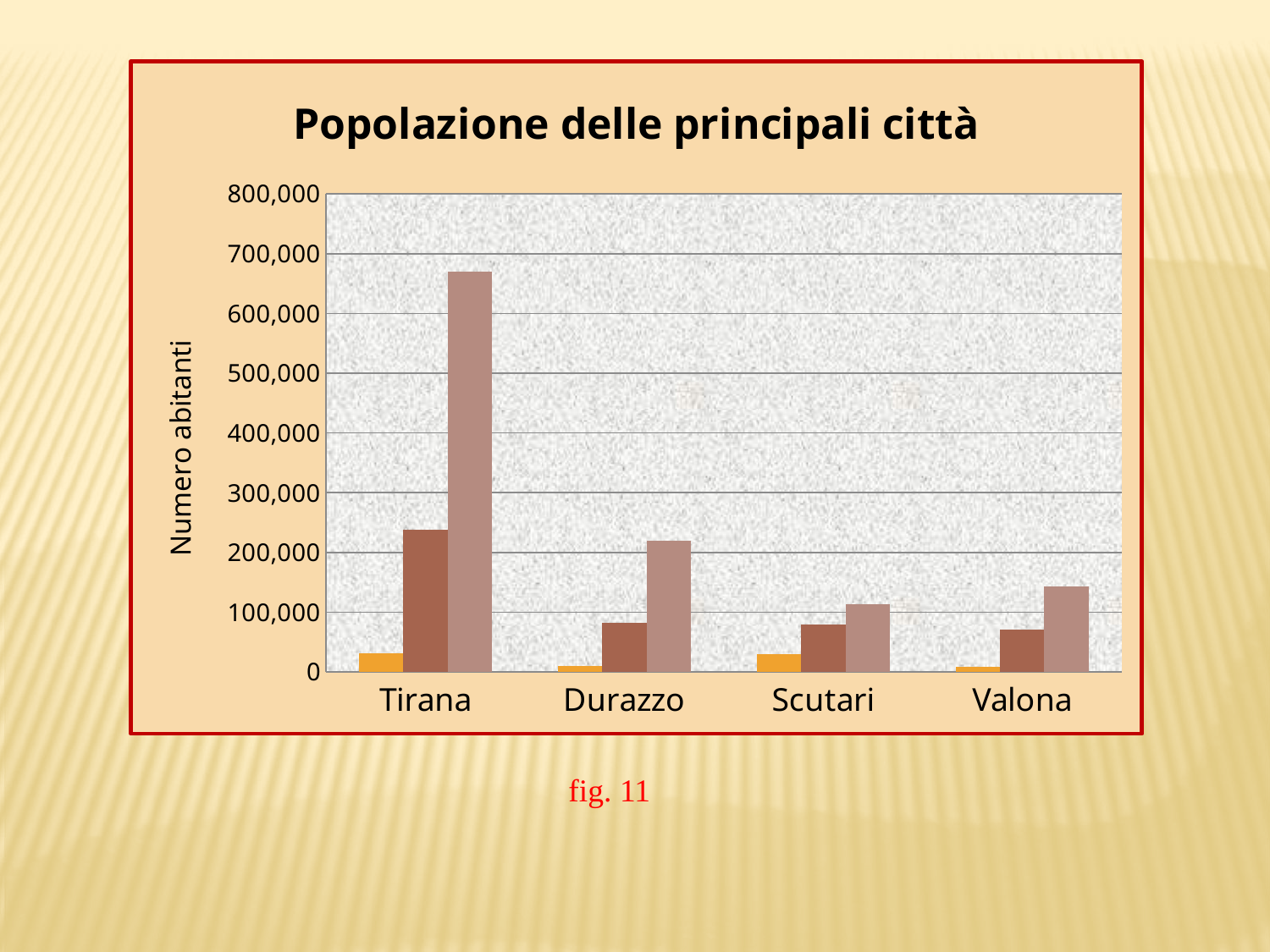
How many bars are plotted for each city? 3 What is the title of the chart? Popolazione delle principali città What is the highest value shown on the vertical axis? 800,000 Which city has a larger tallest bar, Durazzo or Valona? Durazzo Is the tallest bar for Durazzo greater or less than 300,000? less Which city has the tallest bar in the chart? Tirana How many cities are shown on the x axis of the chart? 4 What kind of chart is shown on the slide? bar chart Is the tallest bar for Scutari greater or less than 200,000? less What is the label of the vertical axis? Numero abitanti Is the tallest bar for Valona greater or less than 100,000? greater